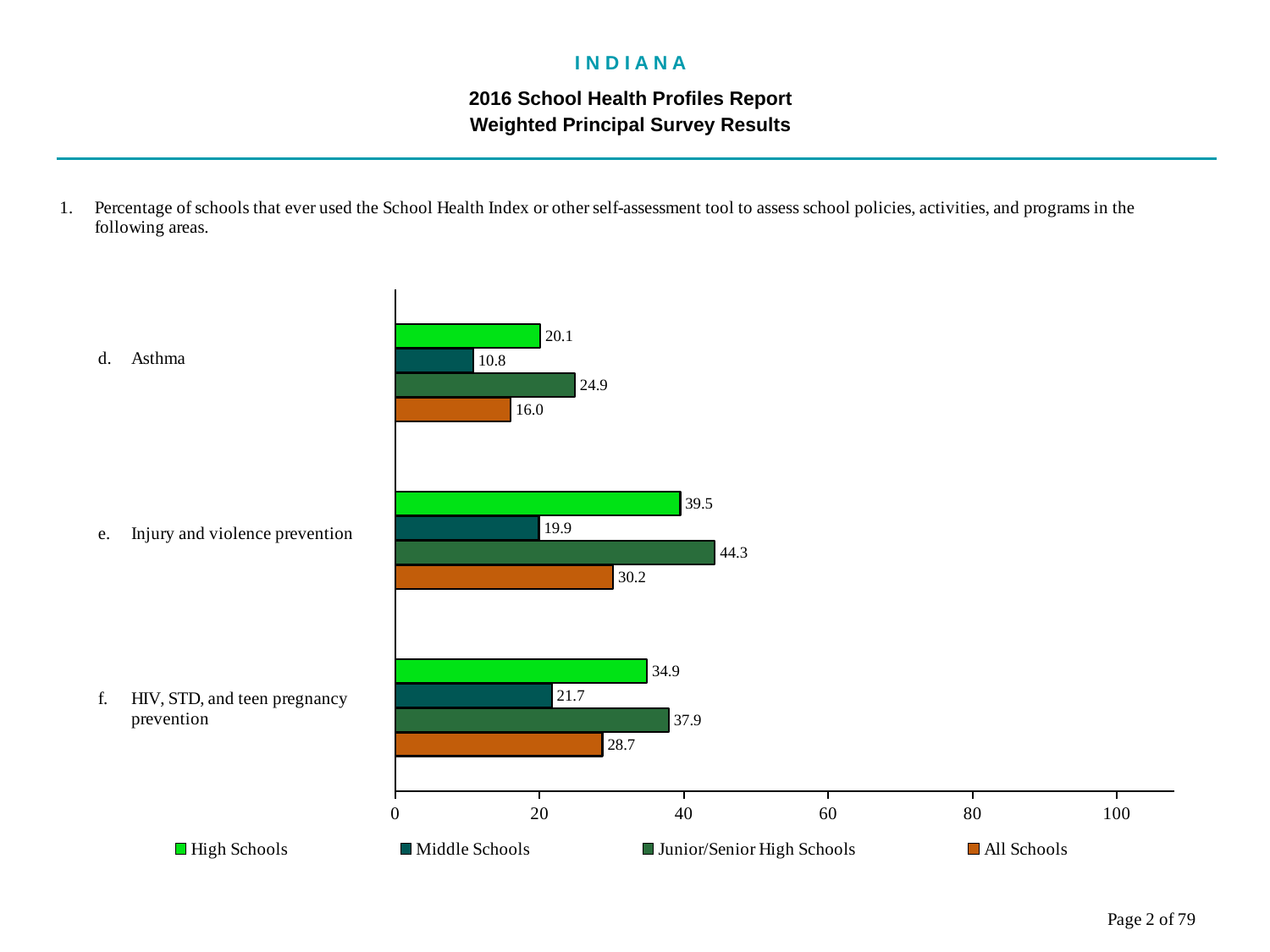
How many categories are shown on the chart? 3 What is the value for High Schools in the Asthma category? 20.1 Which series is shown in orange in the legend? All Schools What is the value for Middle Schools in the Injury and violence prevention category? 19.9 Is the value for Junior/Senior High Schools in the Injury and violence prevention category greater or less than 40? greater What is the value for All Schools in the HIV, STD, and teen pregnancy prevention category? 28.7 Which category has the lowest value for Middle Schools? Asthma What kind of chart is shown on the slide? bar chart How many series does the legend list? 4 Which is larger in the Asthma category: the Junior/Senior High Schools value or the All Schools value? Junior/Senior High Schools Which category has the highest value for Junior/Senior High Schools? Injury and violence prevention What is the difference between the High Schools and Middle Schools values in the Injury and violence prevention category? 19.6